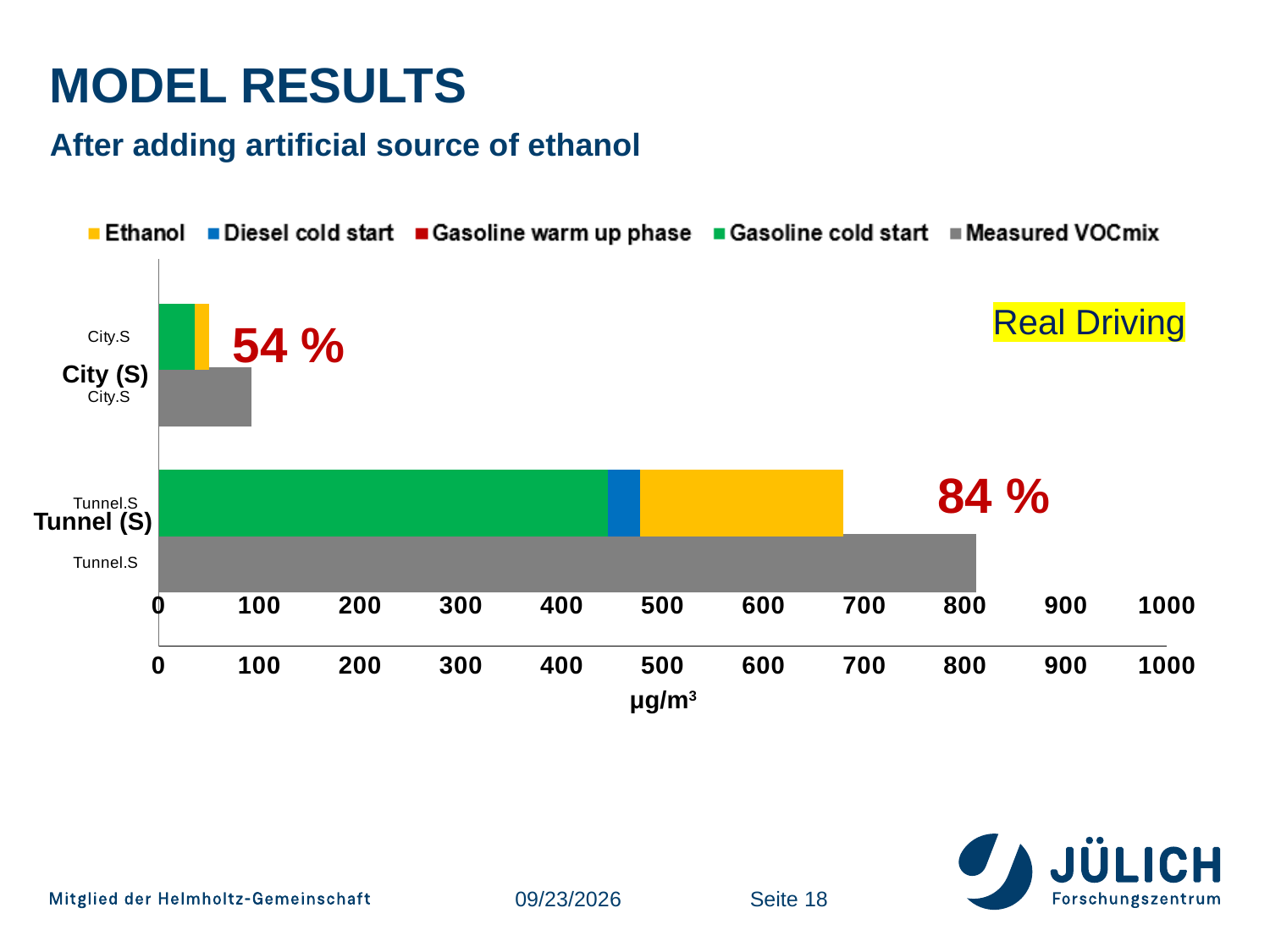
What percentage label is printed next to the City (S) bars? 54 % Which has the larger Measured VOCmix bar, City.S or Tunnel.S? Tunnel.S What percentage label is printed next to the Tunnel (S) bars? 84 % Is the Measured VOCmix value for Tunnel.S greater or less than 700? greater Is the Gasoline cold start value for Tunnel.S greater or less than 500? less Which legend entry is shown in grey? Measured VOCmix Is the total of the stacked modelled bar for Tunnel.S greater or less than 600? greater How many series does the chart legend list? 5 What kind of chart is shown on the slide? bar chart What unit is shown on the x axis of the chart? µg/m³